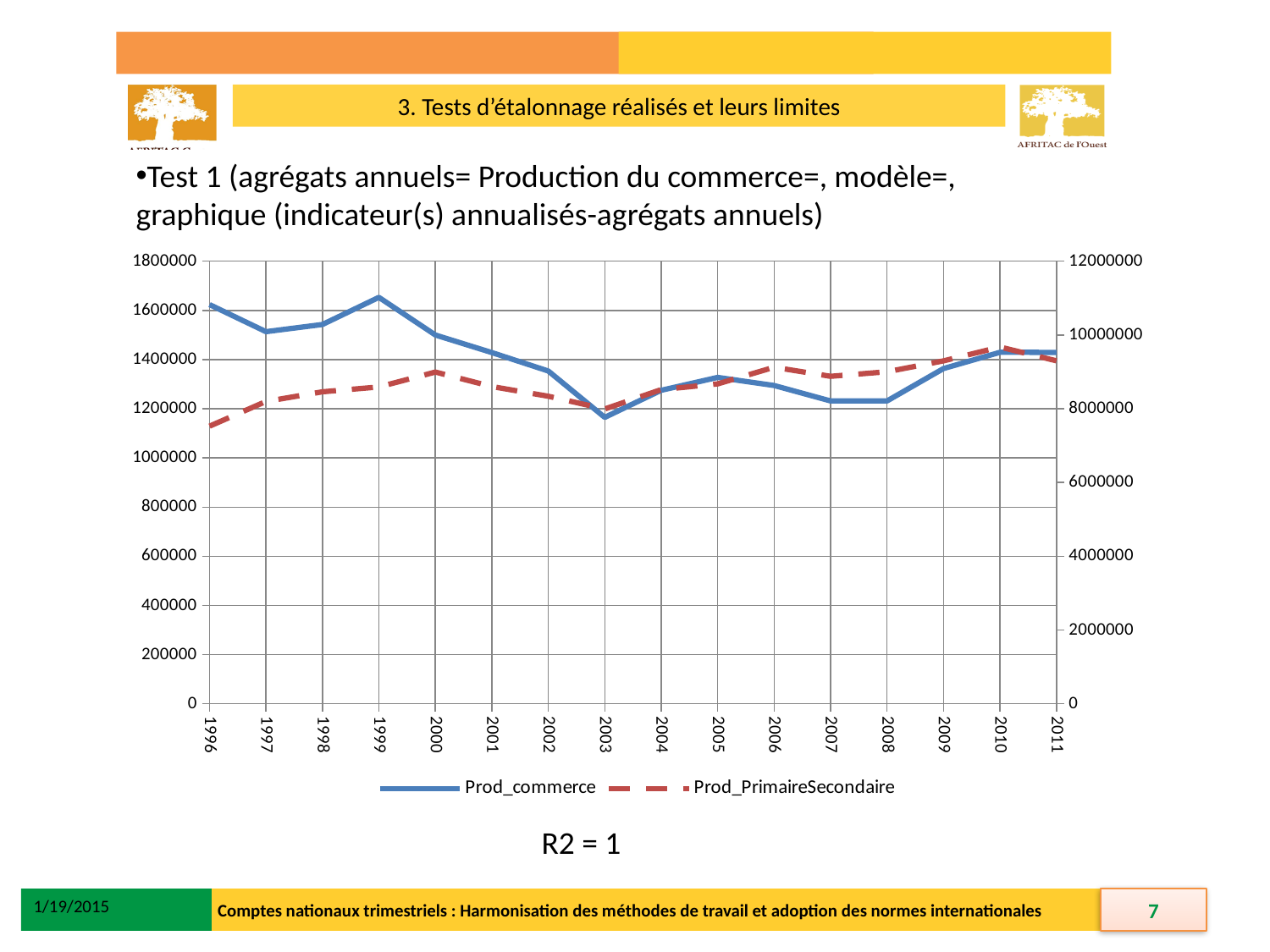
How many years are plotted along the x axis? 16 In which year does Prod_commerce reach its lowest value? 2003 Does Prod_commerce rise or fall between 1999 and 2003? fall Is the value for Prod_PrimaireSecondaire in 1996 greater or less than 8000000 on the right axis? less In which year does Prod_PrimaireSecondaire reach its lowest value? 1996 How many series does the legend list? 2 Is the value for Prod_commerce in 1999 greater or less than 1600000? greater In which year does Prod_commerce reach its highest value? 1999 What kind of chart is shown on the slide? line chart Which series is drawn with a dashed red line? Prod_PrimaireSecondaire Is the value for Prod_commerce in 2003 greater or less than 1200000? less What R2 value is stated below the chart? R2 = 1